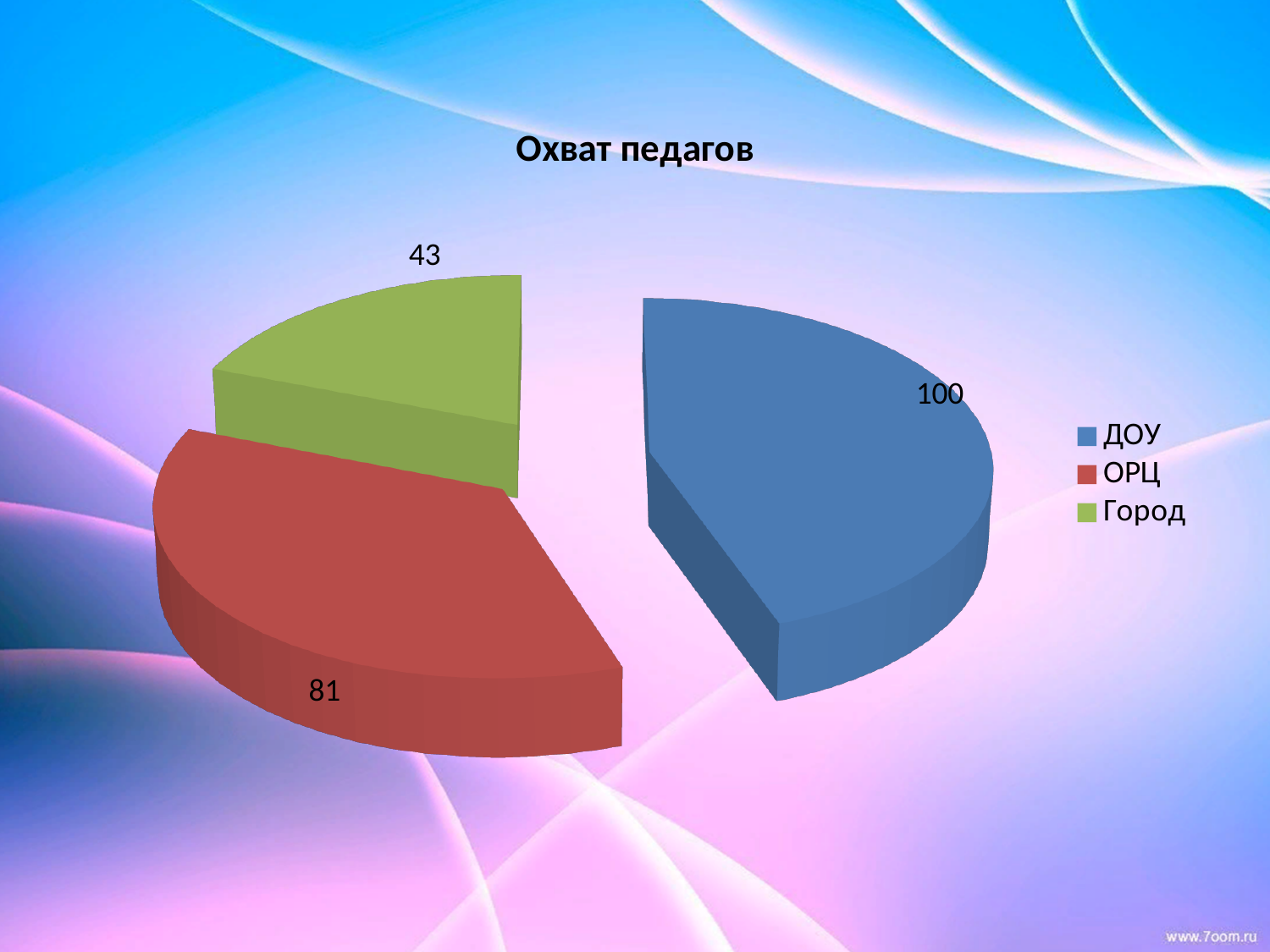
What type of chart is shown on the slide? pie chart What is the value for ДОУ? 100 What is the difference between the values for ДОУ and ОРЦ? 19 Which category has the largest slice? ДОУ What is the value for Город? 43 Which category has the smallest slice? Город Which is larger, the value for ОРЦ or the value for Город? ОРЦ What is the title of the chart? Охват педагов What is the value for ОРЦ? 81 What is the difference between the values for ОРЦ and Город? 38 What colour is the slice for Город? green How many categories does the pie chart have? 3